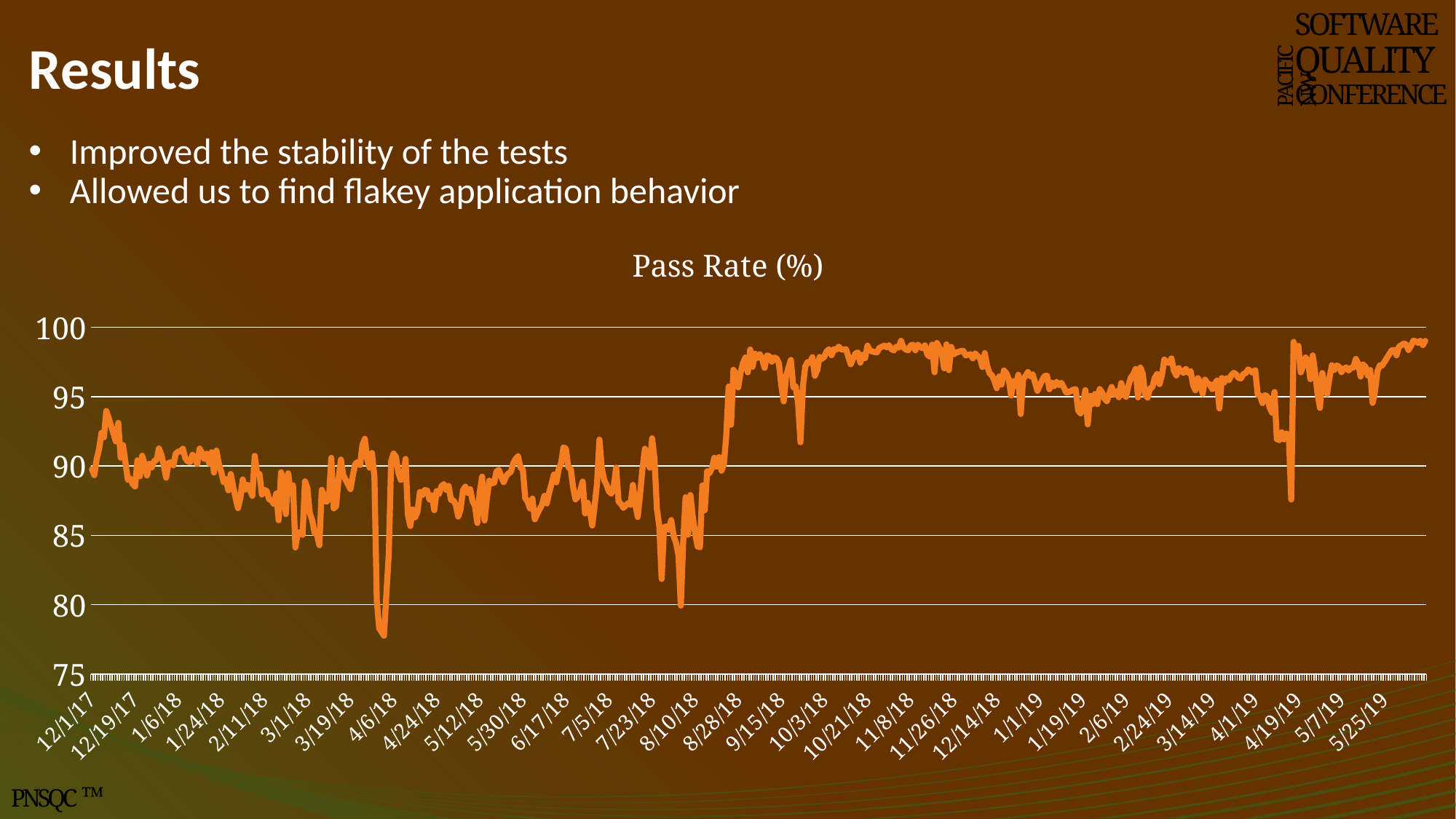
Near which x-axis date label does the lowest point of the line occur? 4/6/18 What are the lowest and highest values shown on the y axis of the chart? 75 and 100 Is the pass rate around 10/3/18 greater or less than 95? greater Is the pass rate around 12/1/17 greater or less than 85? greater Is the pass rate around 5/25/19 greater or less than 95? greater What kind of chart is shown on the slide? line chart Which is higher, the pass rate around 11/8/18 or the pass rate around 4/6/18? 11/8/18 Overall, does the pass rate rise or fall from 12/1/17 to 5/25/19? rise What is the title of the chart? Pass Rate (%)